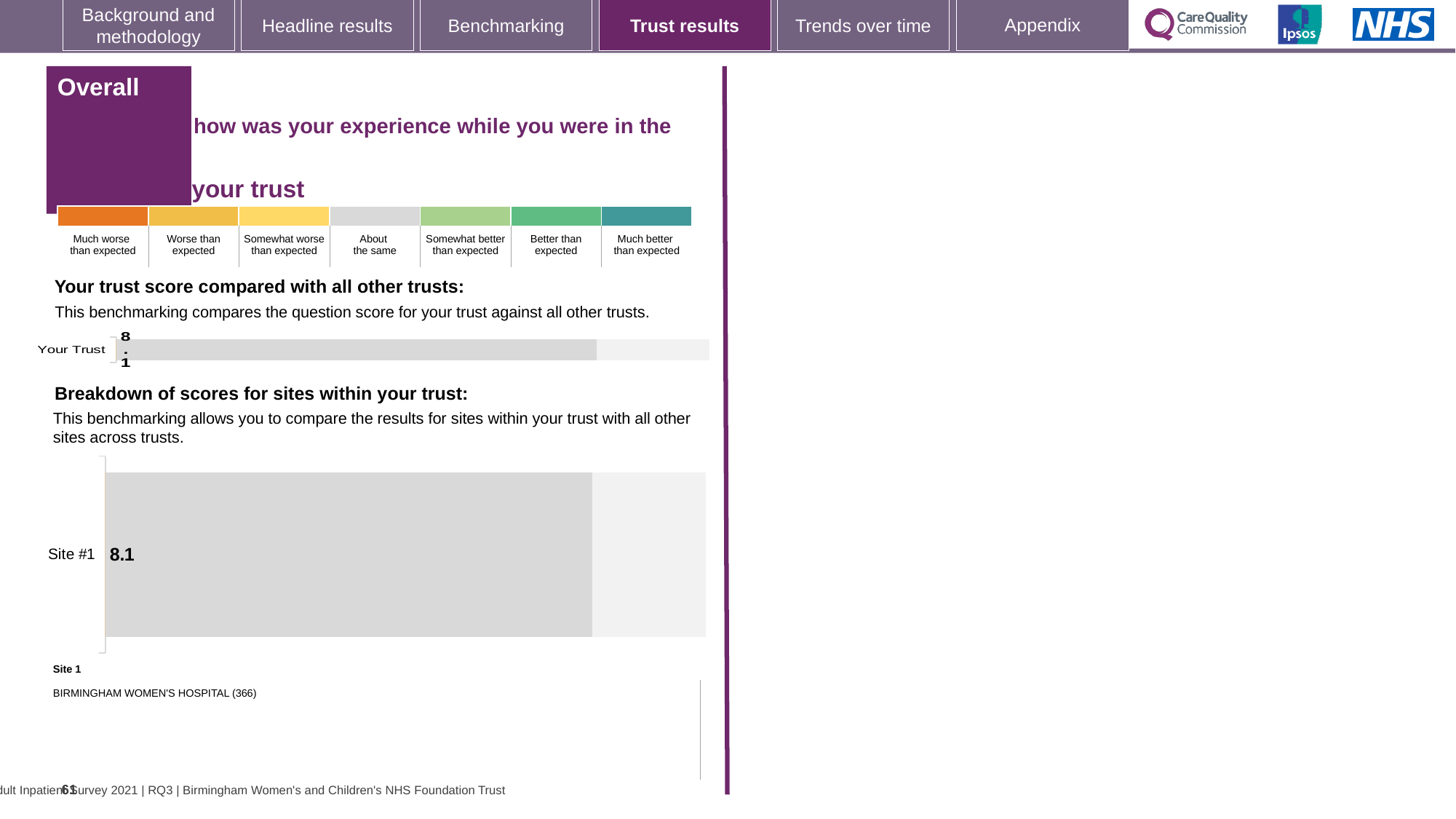
Which site is labelled Site #1 in the 'Breakdown of scores for sites within your trust' chart? BIRMINGHAM WOMEN'S HOSPITAL (366) How many categories are plotted in the 'Your trust score compared with all other trusts' chart? 1 How many sites are plotted in the 'Breakdown of scores for sites within your trust' chart? 1 In the 'Breakdown of scores for sites within your trust' chart, what is the score for Site #1? 8.1 What kind of chart is the 'Breakdown of scores for sites within your trust' chart? bar chart What kind of chart is the 'Your trust score compared with all other trusts' chart? bar chart How many rating categories does the colour key above the charts show, from 'Much worse than expected' to 'Much better than expected'? 7 What is the difference between the Your Trust score and the Site #1 score? 0 In the 'Your trust score compared with all other trusts' chart, what is the score for Your Trust? 8.1